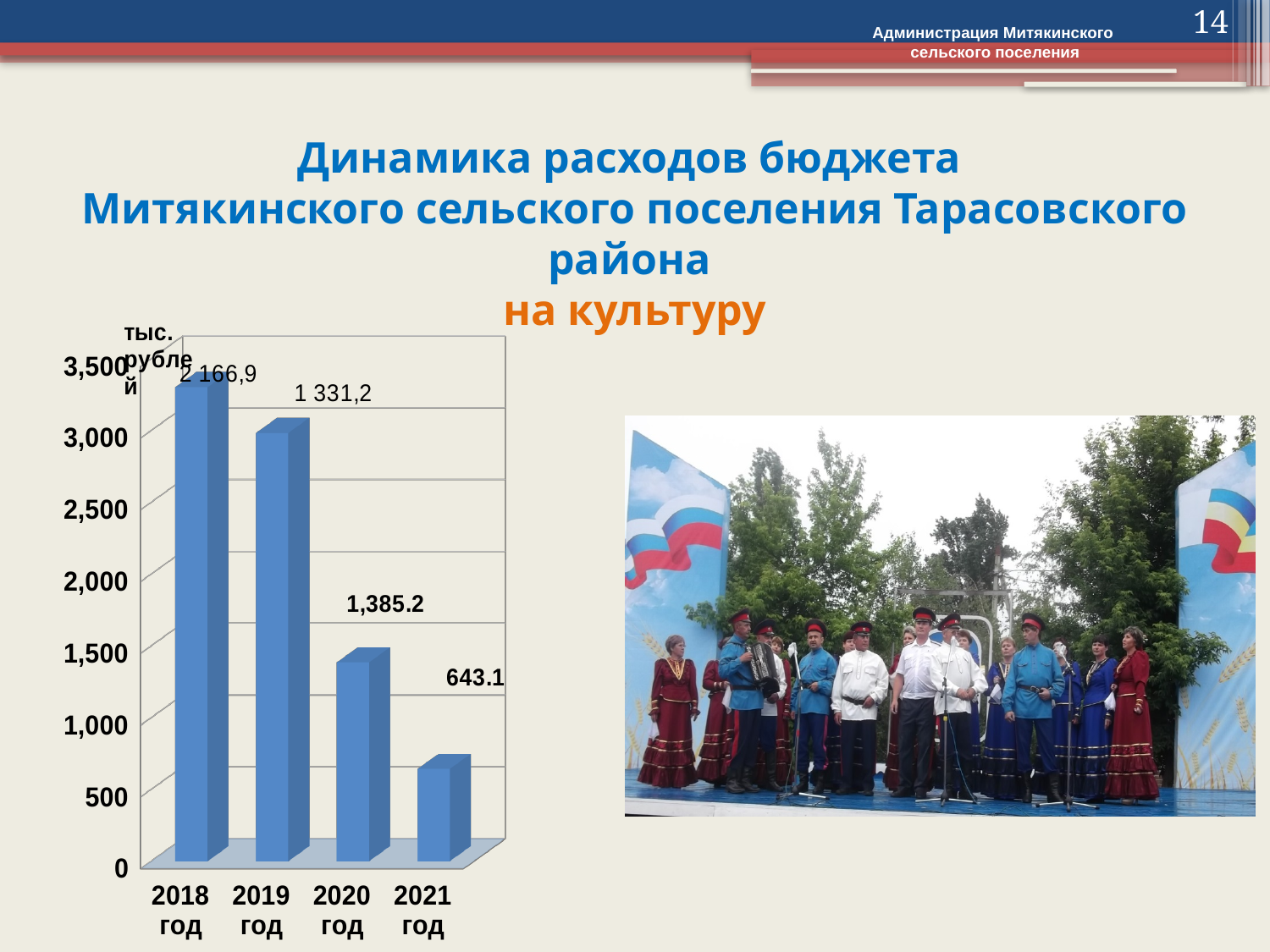
Which is larger, the value for 2020 год or the value for 2021 год? 2020 год Do the values rise or fall from 2018 to 2021 along the x axis? fall Is the value for 2021 год greater or less than 1,000? less What is the value labelled for 2021 год? 643.1 What kind of chart is shown on the slide? bar chart What unit is shown on the vertical axis of the chart? тыс. рублей Which year has the lowest bar on the chart? 2021 год What is the value labelled for 2019 год? 1 331,2 What is the value labelled for 2020 год? 1,385.2 How many years (categories) are shown on the chart? 4 What is the difference between the labelled values for 2020 год and 2021 год? 742.1 Which year has the highest bar on the chart? 2018 год